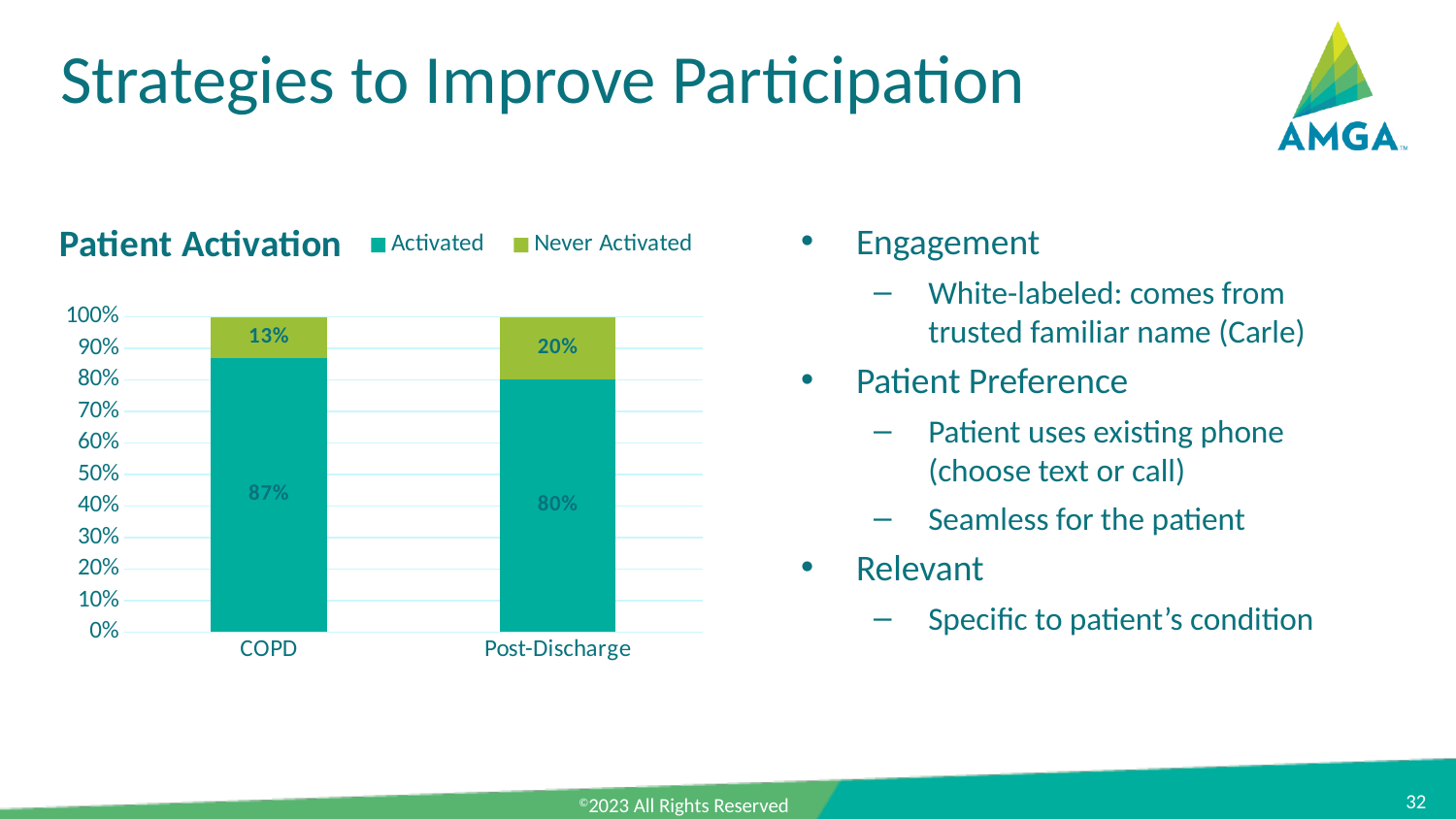
What is the difference between the Activated values for COPD and Post-Discharge? 7% What is the Never Activated value for COPD? 13% Which category has the lower Never Activated value? COPD What is the Activated value for COPD? 87% How many categories are shown on the x axis? 2 What is the Never Activated value for Post-Discharge? 20% Is the Never Activated value larger for COPD or for Post-Discharge? Post-Discharge What is the title of the chart? Patient Activation What kind of chart is shown? Stacked bar chart What is the Activated value for Post-Discharge? 80% How many series does the legend list? 2 Which category has the higher Activated value? COPD